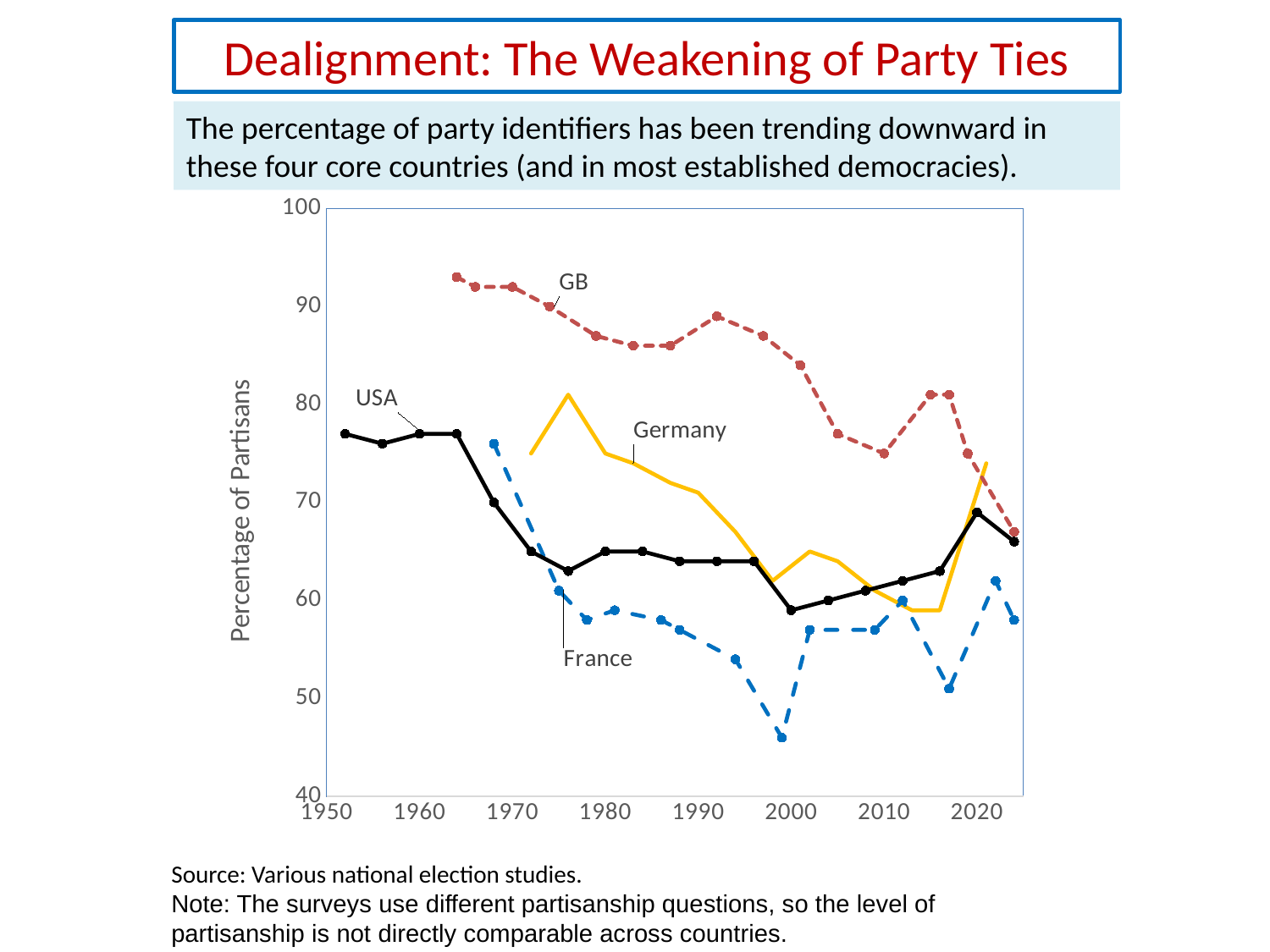
What is the label of the vertical axis of the chart? Percentage of Partisans Which country's line is the highest on the chart for most of the period shown? GB Is the value for GB in the mid-1960s greater or less than 90? greater Is the lowest value for France (around 1999) greater or less than 50? less Is the value for the USA in 1952 greater or less than 70? greater Which country's line reaches the lowest point on the chart? France How many countries (series) are plotted on the chart? 4 What kind of chart is shown on the slide? line chart Around 1999, which is larger, the value for GB or the value for France? GB Does the GB line generally rise or fall from the 1960s to the 2020s? fall What is the lowest year shown on the horizontal axis? 1950